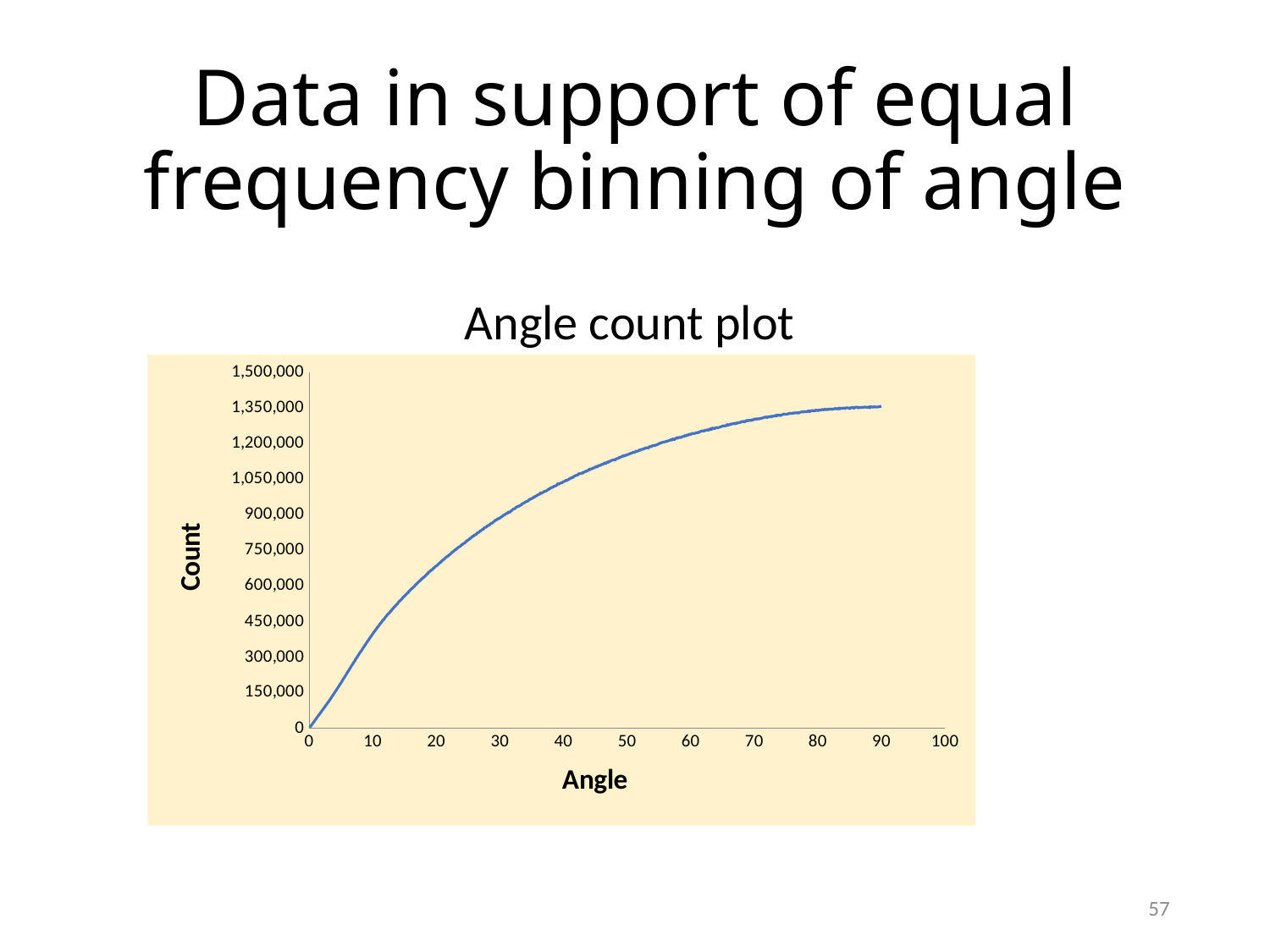
Is the count at an angle of 10 greater or less than 600,000? less Is the count at an angle of 20 greater or less than 750,000? less What is the title of the chart on the slide? Angle count plot What kind of chart is the "Angle count plot"? line chart What is the label of the vertical axis of the chart? Count Is the count at an angle of 90 greater or less than 1,200,000? greater Which angle has the larger count, 20 or 60? 60 At which angle shown on the x axis is the count lowest? 0 Does the count rise or fall as the angle increases from 0 to 90? rise